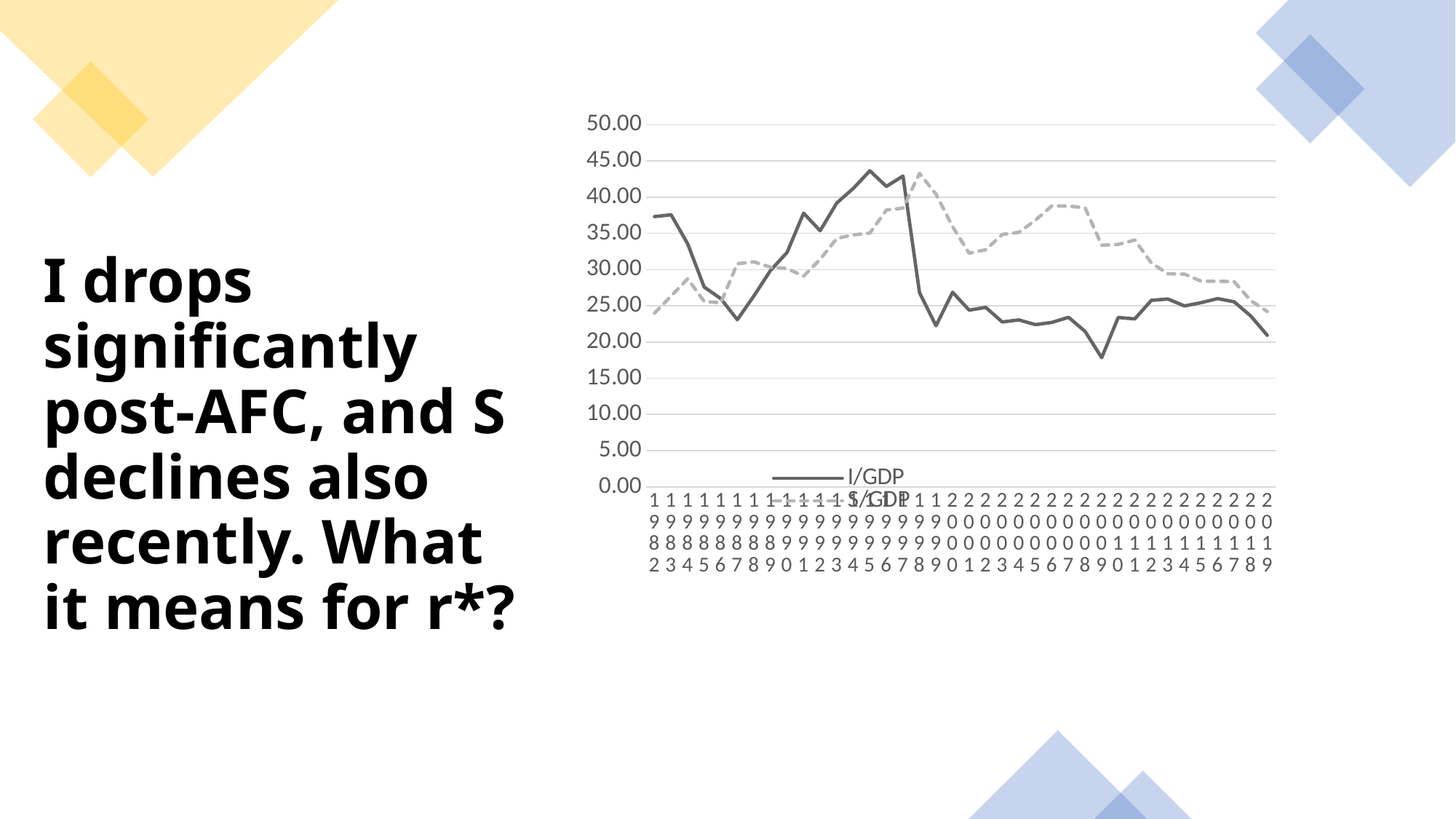
How many series does the chart's legend list? 2 In 2005, which series has the larger value, I/GDP or S/GDP? S/GDP How many years are plotted along the x axis? 38 Is the value of I/GDP in 2010 greater or less than 20.00? greater What is the last year shown on the x axis? 2019 What is the first year shown on the x axis? 1982 In which year does S/GDP reach its highest value? 1998 Is the value of S/GDP in 2008 greater or less than 35.00? greater What kind of chart is shown on the slide? line chart Which series is drawn with a dashed line? S/GDP What are the two series named in the legend? I/GDP and S/GDP In which year does I/GDP reach its lowest value? 2009